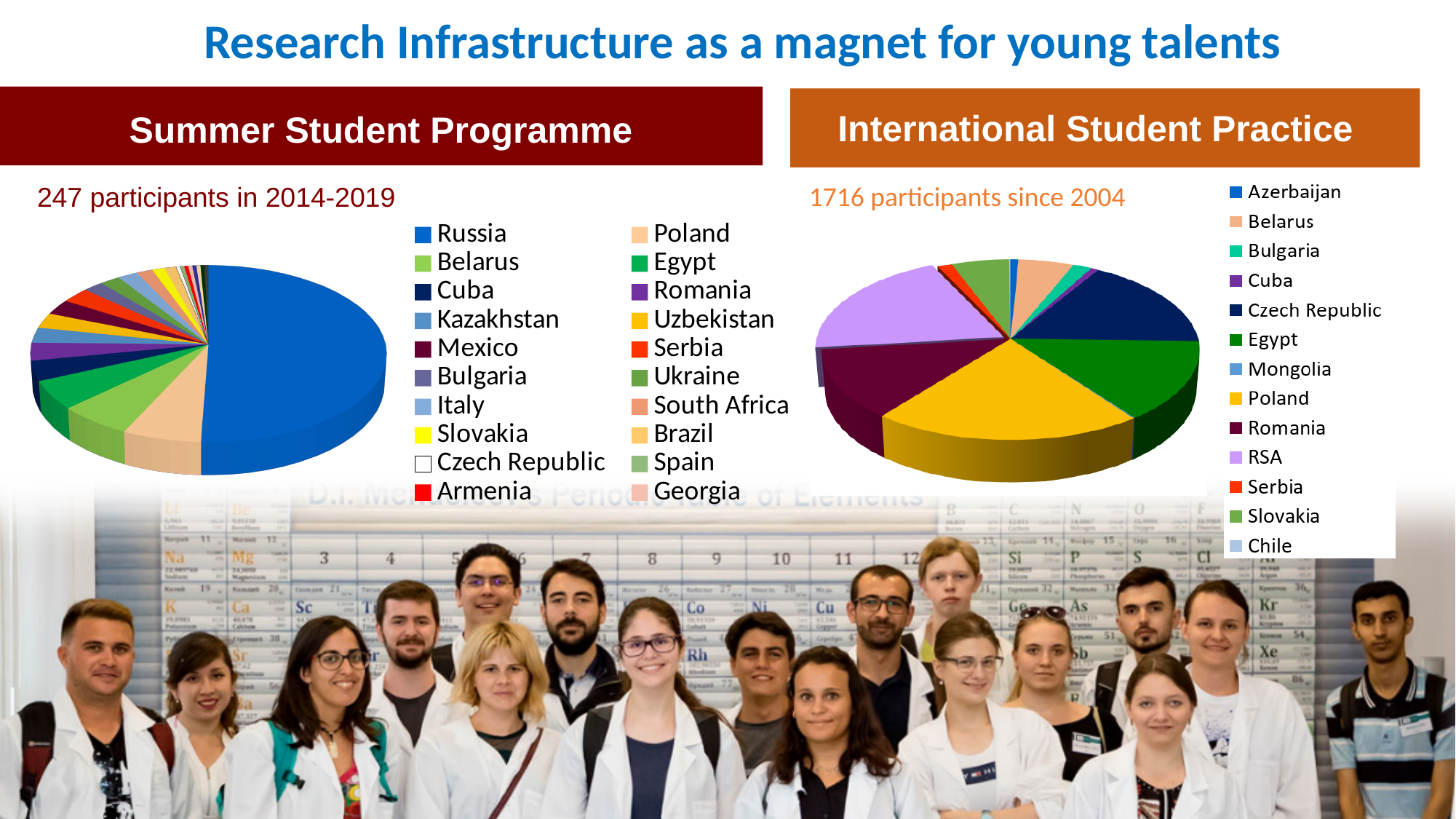
How many countries are listed in the legend of the International Student Practice pie chart? 13 What kind of chart is used under the International Student Practice heading? Pie chart In the International Student Practice pie chart, which slice is larger, Poland or Egypt? Poland In the International Student Practice pie chart, which slice is larger, Czech Republic or Azerbaijan? Czech Republic How many countries are listed in the legend of the Summer Student Programme pie chart? 20 In the International Student Practice pie chart, which country has the largest slice? Poland In the Summer Student Programme pie chart, which country has the largest slice? Russia How many participants does the International Student Practice chart report since 2004? 1716 What kind of chart is used under the Summer Student Programme heading? Pie chart In the International Student Practice pie chart, which slice is larger, Romania or Serbia? Romania How many participants does the Summer Student Programme chart report for 2014-2019? 247